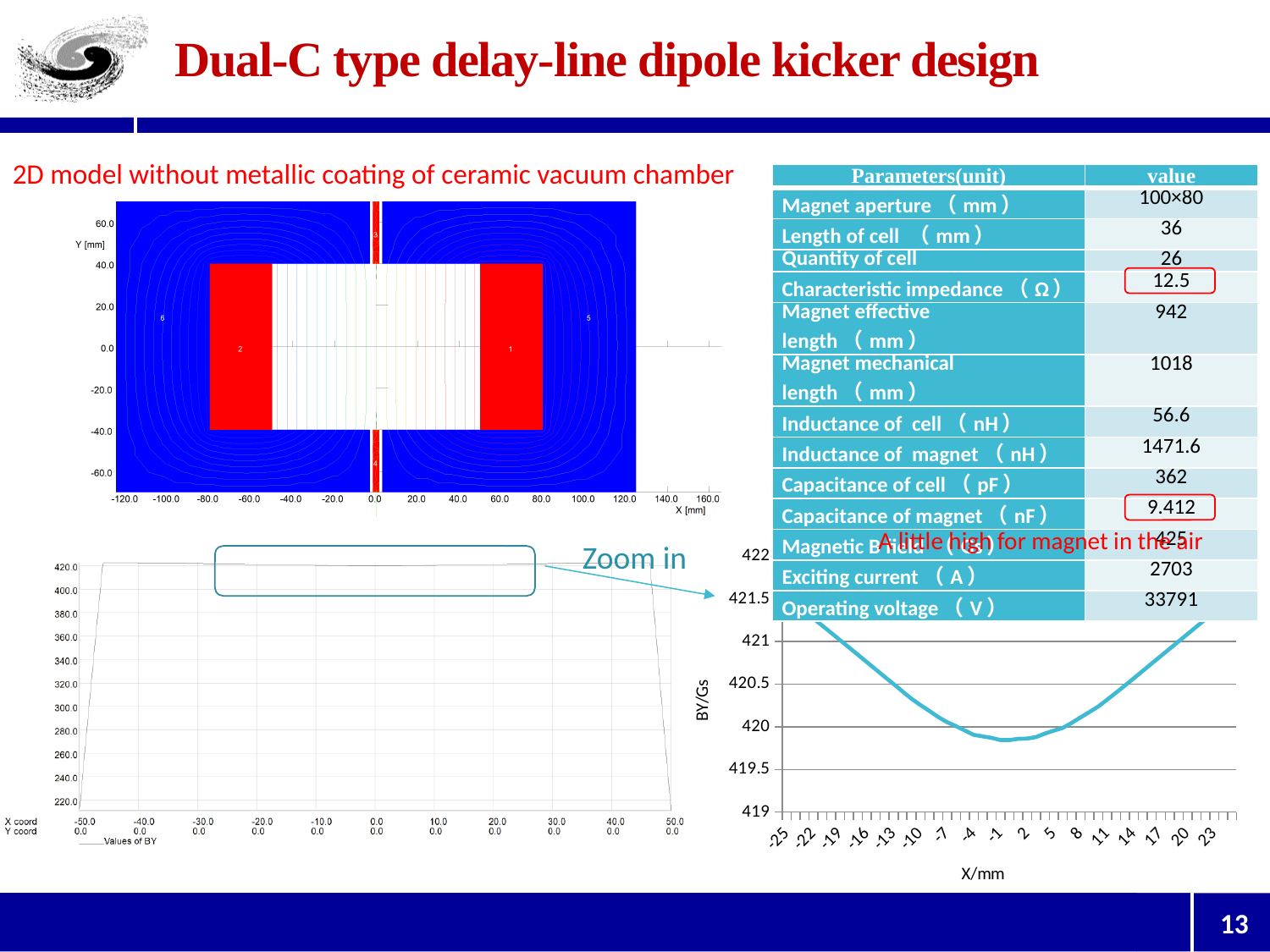
In the bottom-right chart (BY/Gs vs X/mm), what kind of chart is shown? line chart In the bottom-right chart (BY/Gs vs X/mm), is the value at X = -1 greater or less than 420? less In the bottom-right chart (BY/Gs vs X/mm), how does the value change as X goes from about 0 to 23? rises In the bottom-left chart (Values of BY), is the value at X coord -50.0 greater or less than 300.0? less In the bottom-right chart, what is the label of the x axis? X/mm In the bottom-left chart (Values of BY), what kind of chart is shown? line chart In the bottom-right chart (BY/Gs vs X/mm), is the value at X = -25 greater or less than 421? greater In the bottom-right chart, what is the label of the y axis? BY/Gs In the bottom-right chart (BY/Gs vs X/mm), how does the value change as X goes from -25 to about 0? falls In the bottom-right chart (BY/Gs vs X/mm), which is larger, the value at X = -25 or the value at X = 2? X = -25